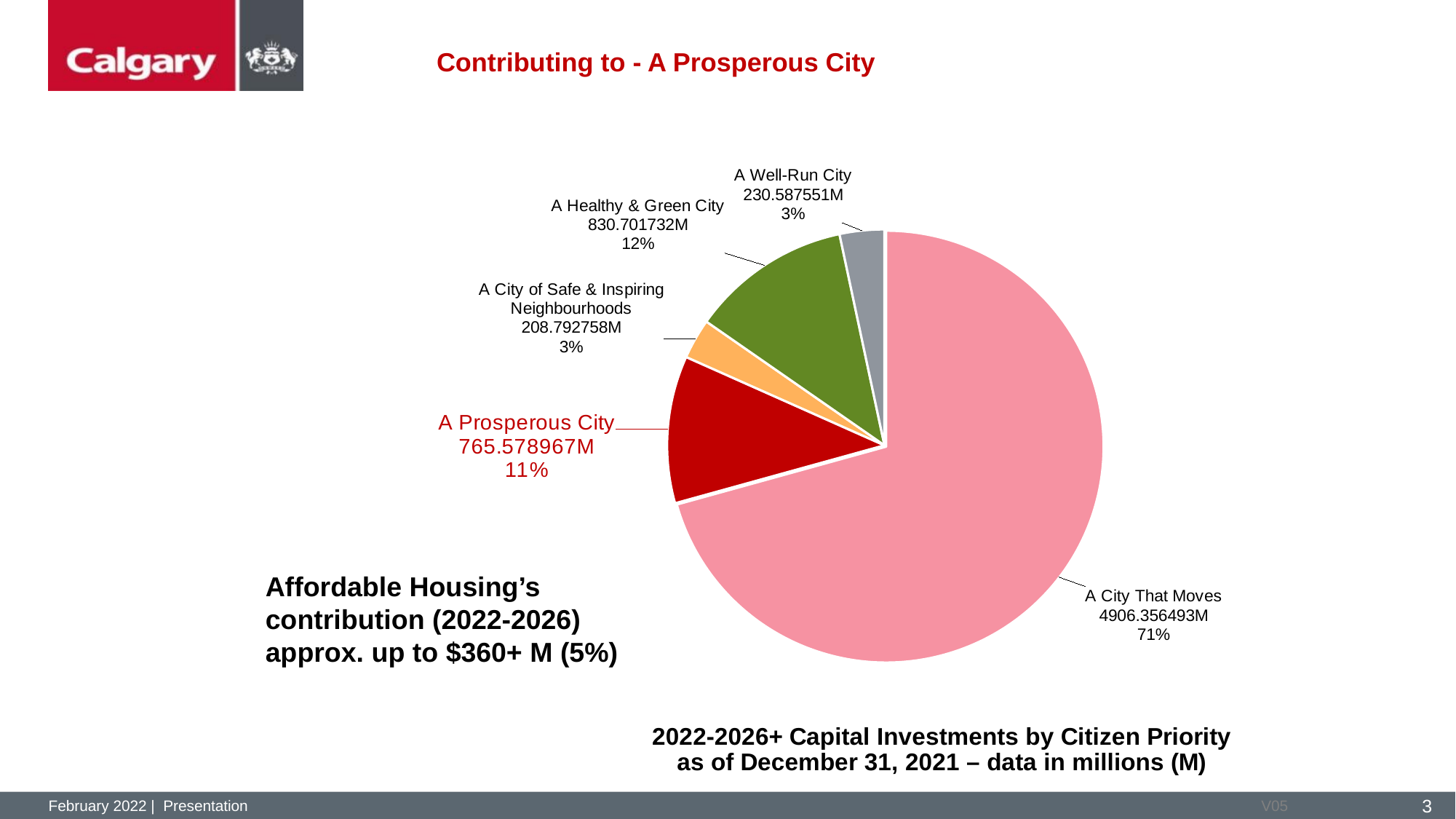
What is the value for A City That Moves? 4906.356493M Which category has the smallest value in the pie chart? A City of Safe & Inspiring Neighbourhoods What is the value for A Healthy & Green City? 830.701732M Which is larger, A Healthy & Green City or A Prosperous City? A Healthy & Green City What is the title of the chart? 2022-2026+ Capital Investments by Citizen Priority as of December 31, 2021 – data in millions (M) What share of the pie does A City That Moves represent? 71% Which category has the largest slice of the pie? A City That Moves What share of the pie does A Prosperous City represent? 11% What kind of chart is shown on the slide? Pie chart What is the value for A Prosperous City? 765.578967M How many slices does the pie chart have? 5 What is the value for A Well-Run City? 230.587551M